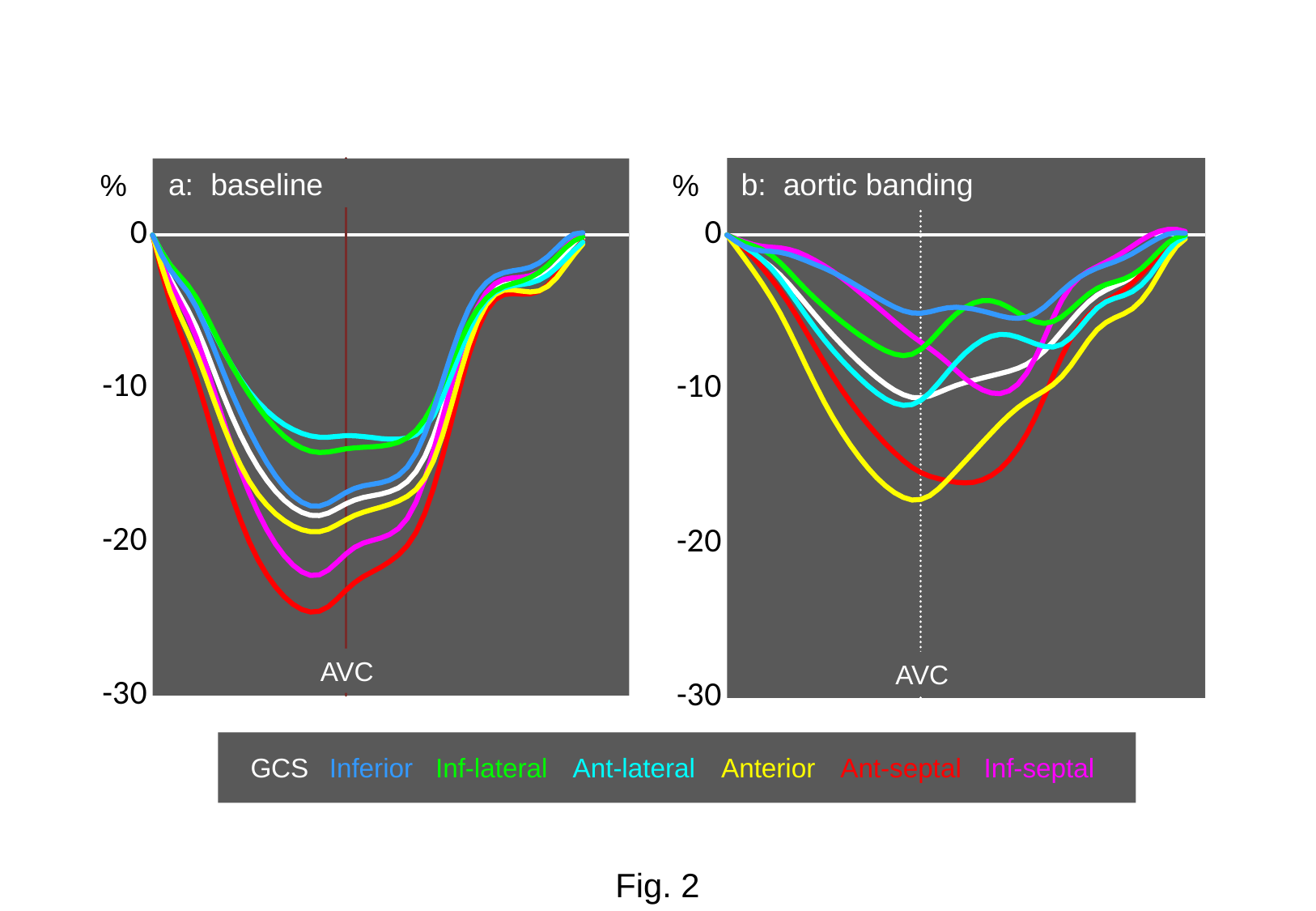
In chart b: aortic banding, which series reaches the lowest (most negative) value? Anterior What kind of chart is shown in panel a: baseline? line chart In chart a: baseline, which series reaches the lowest (most negative) value? Ant-septal What label is given to the vertical line in each chart? AVC In chart a: baseline, is the lowest value of the Inf-lateral curve greater or less than -20? greater In chart b: aortic banding, which curve dips lower, Anterior or Inferior? Anterior In chart b: aortic banding, is the lowest value of the Ant-septal curve greater or less than -10? less In chart a: baseline, is the lowest value of the Ant-septal curve greater or less than -20? less How many series does the legend list? 7 How many charts are shown on the slide? 2 In chart a: baseline, which curve dips lower, Inf-septal or Inf-lateral? Inf-septal